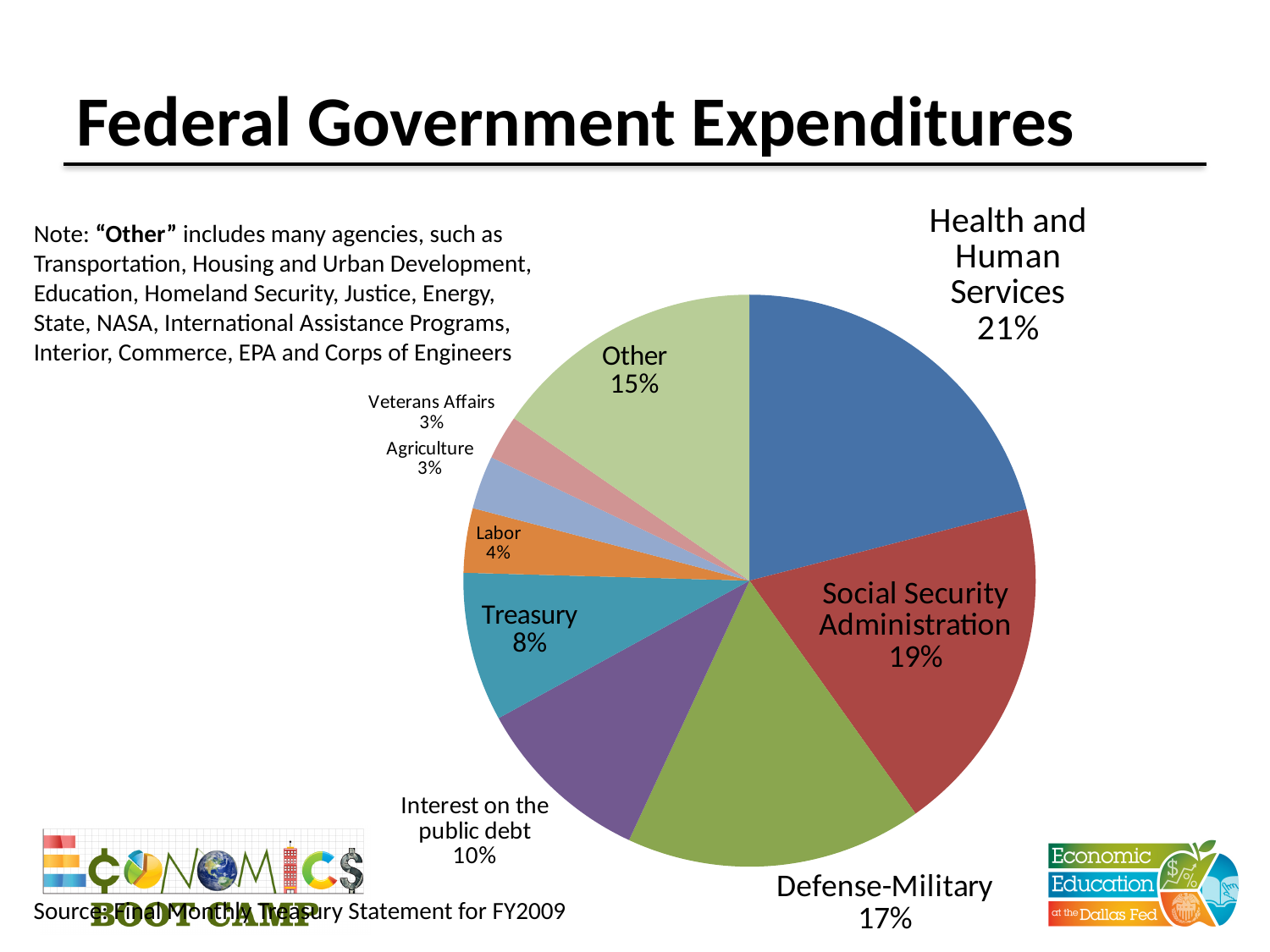
How many slices does the pie chart have? 9 What is the title of the chart on the slide? Federal Government Expenditures Which category has the largest share of federal government expenditures? Health and Human Services What percentage of expenditures goes to Defense-Military? 17% What share of the pie is Interest on the public debt? 10% What kind of chart is shown on the slide? Pie chart What percentage of expenditures is labelled for the Social Security Administration? 19% What is the difference in percentage points between Health and Human Services and Defense-Military? 4 percentage points What is the combined share of Treasury and Labor? 12% Which category has the smallest share, Labor or Treasury? Labor What share of federal government expenditures goes to Health and Human Services? 21% Which is larger, the share for Other or the share for Treasury? Other